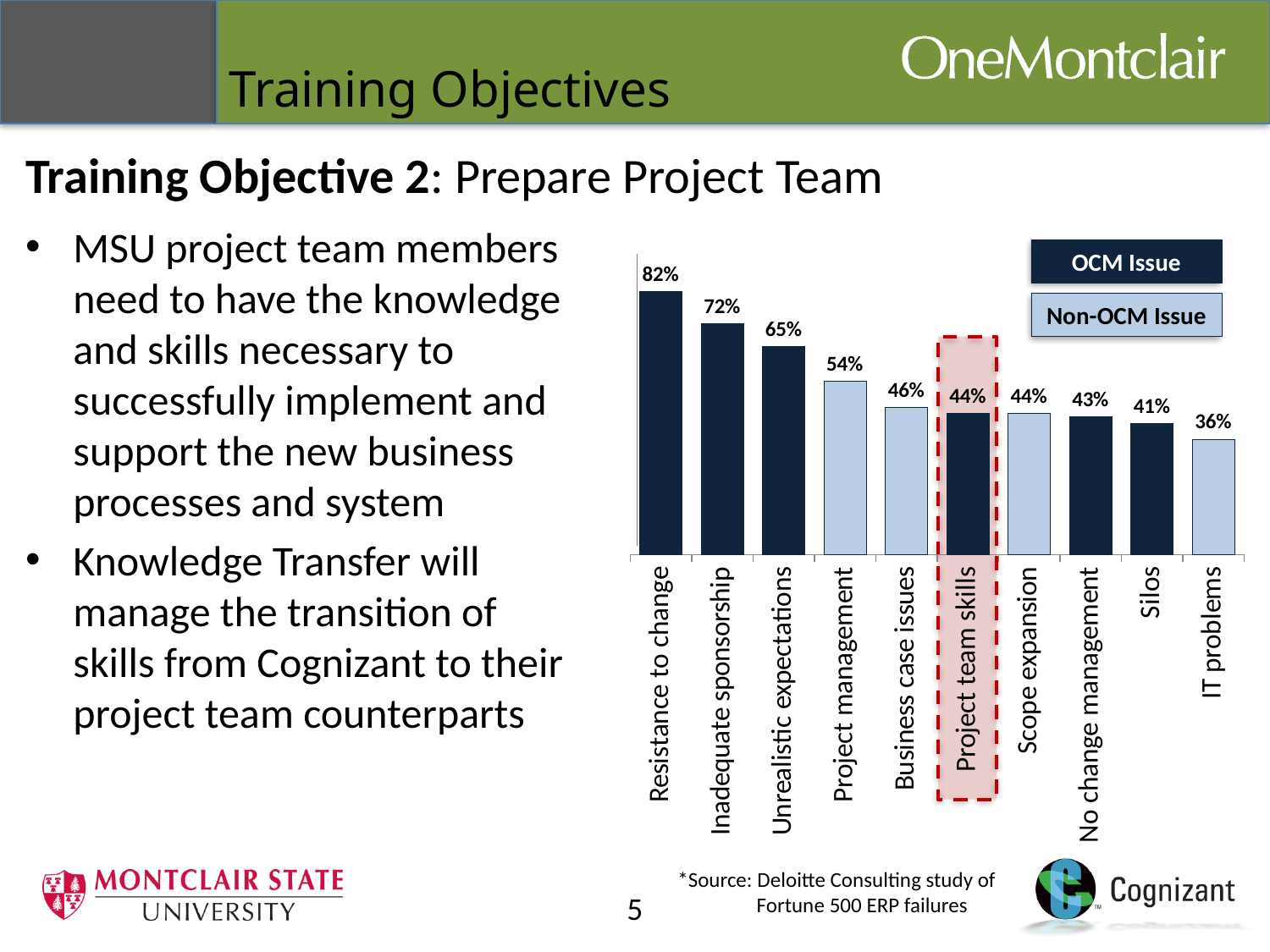
Which category is highlighted with a red dashed outline? Project team skills Which category has the highest value? Resistance to change Which category has the lowest value? IT problems What is the value for Resistance to change? 82% What kind of chart is shown on the slide? Bar chart Which is larger, Project management or Business case issues? Project management What is the value for Project team skills? 44% What is the value for IT problems? 36% What is the value for Unrealistic expectations? 65% How many categories are shown in the chart? 10 What is the difference between Resistance to change and Inadequate sponsorship? 10% How many entries does the legend list? 2